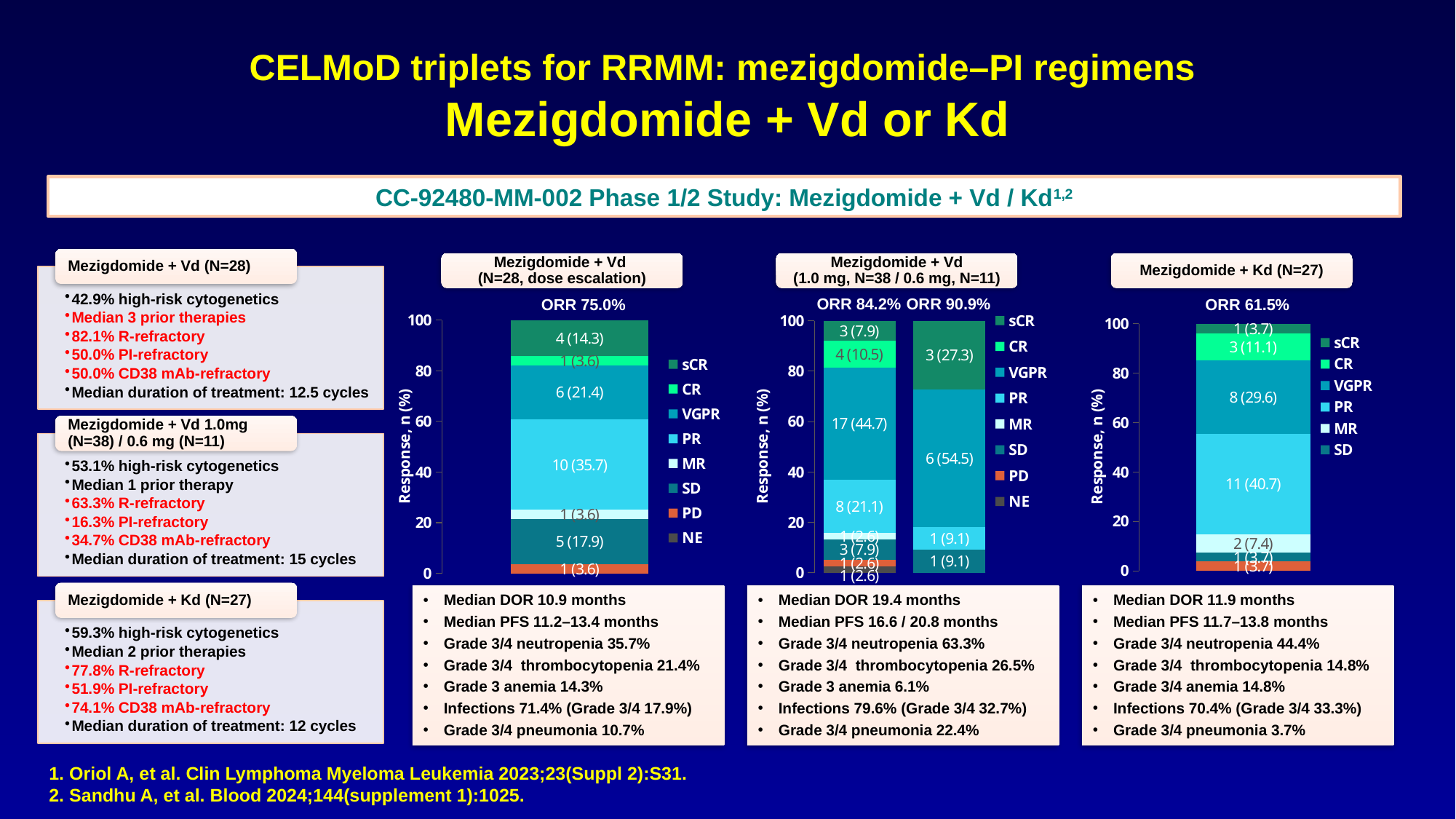
In the Mezigdomide + Vd (1.0 mg, N=38 / 0.6 mg, N=11) chart, how many bars are plotted? 2 In the Mezigdomide + Vd (1.0 mg, N=38 / 0.6 mg, N=11) chart, what is the VGPR value for the 1.0 mg bar? 17 (44.7) In the Mezigdomide + Vd (N=28, dose escalation) chart, which response category has the largest segment? PR What type of chart is used for the Mezigdomide + Kd (N=27) data? Stacked bar chart In the Mezigdomide + Vd (N=28, dose escalation) chart, what is the SD value shown on the bar? 5 (17.9) In the Mezigdomide + Vd (1.0 mg, N=38 / 0.6 mg, N=11) chart, what is the sCR value for the 0.6 mg bar? 3 (27.3) In the Mezigdomide + Vd (N=28, dose escalation) chart, how many entries does the legend list? 8 In the Mezigdomide + Vd (1.0 mg, N=38 / 0.6 mg, N=11) chart, what ORR is shown above the 0.6 mg bar? ORR 90.9% In the Mezigdomide + Kd (N=27) chart, how many entries does the legend list? 6 In the Mezigdomide + Kd (N=27) chart, what is the difference in patient count between the PR and VGPR segments? 3 In the Mezigdomide + Kd (N=27) chart, what is the PR value shown on the bar? 11 (40.7) In the Mezigdomide + Vd (N=28, dose escalation) chart, what is the PR value shown on the bar? 10 (35.7)